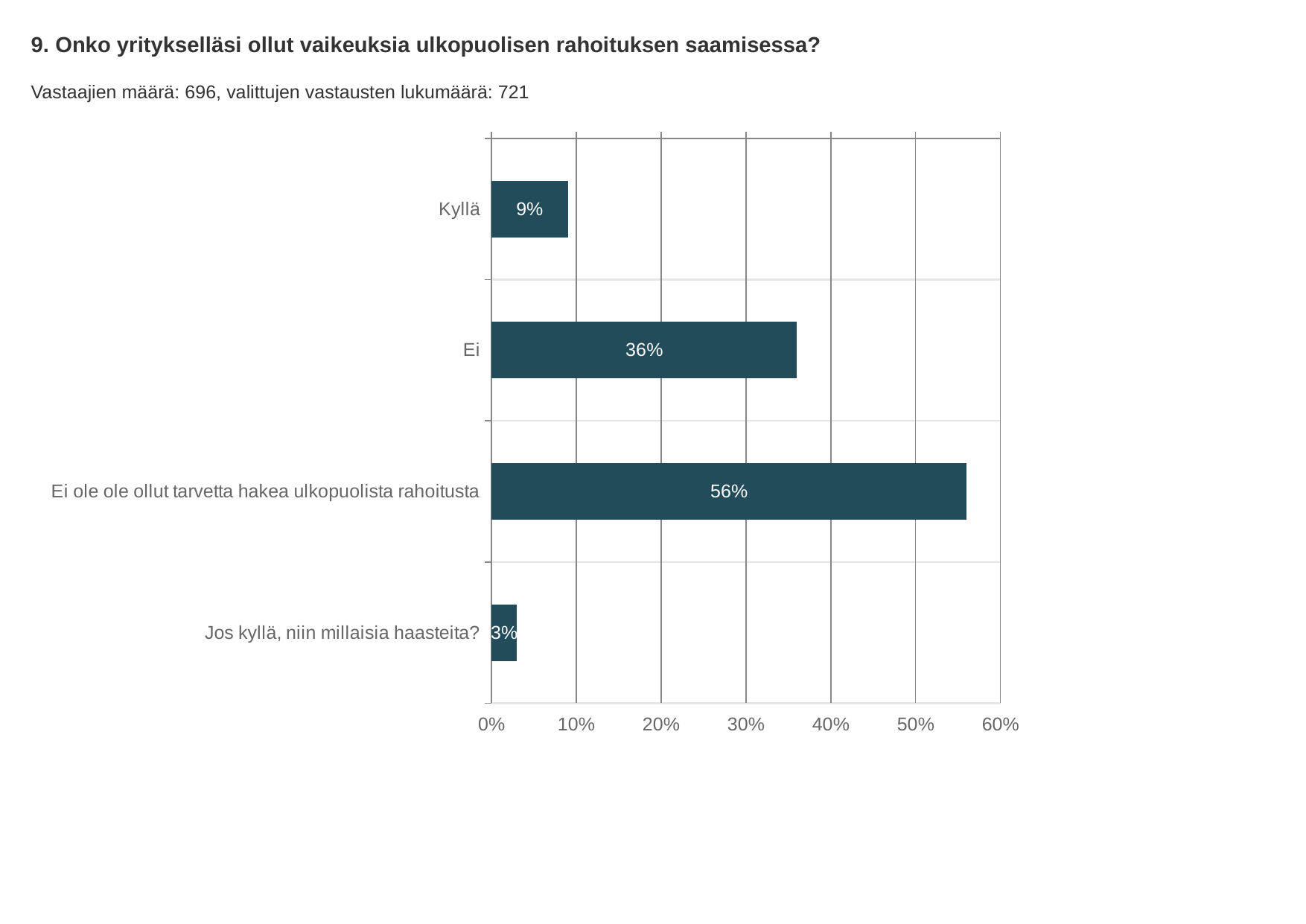
What is the value for "Ei ole ole ollut tarvetta hakea ulkopuolista rahoitusta"? 56% What is the value for "Ei"? 36% What is the difference between the values for "Kyllä" and "Jos kyllä, niin millaisia haasteita?"? 6% What is the value for "Jos kyllä, niin millaisia haasteita?"? 3% How many categories are shown in the chart? 4 What is the title of the chart? 9. Onko yritykselläsi ollut vaikeuksia ulkopuolisen rahoituksen saamisessa? Which category has the highest value? Ei ole ole ollut tarvetta hakea ulkopuolista rahoitusta Which category has the lowest value? Jos kyllä, niin millaisia haasteita? What is the value for "Kyllä"? 9% Which is larger, the value for "Kyllä" or the value for "Ei"? Ei What kind of chart is shown on the slide? Bar chart What is the difference between the values for "Ei ole ole ollut tarvetta hakea ulkopuolista rahoitusta" and "Ei"? 20%